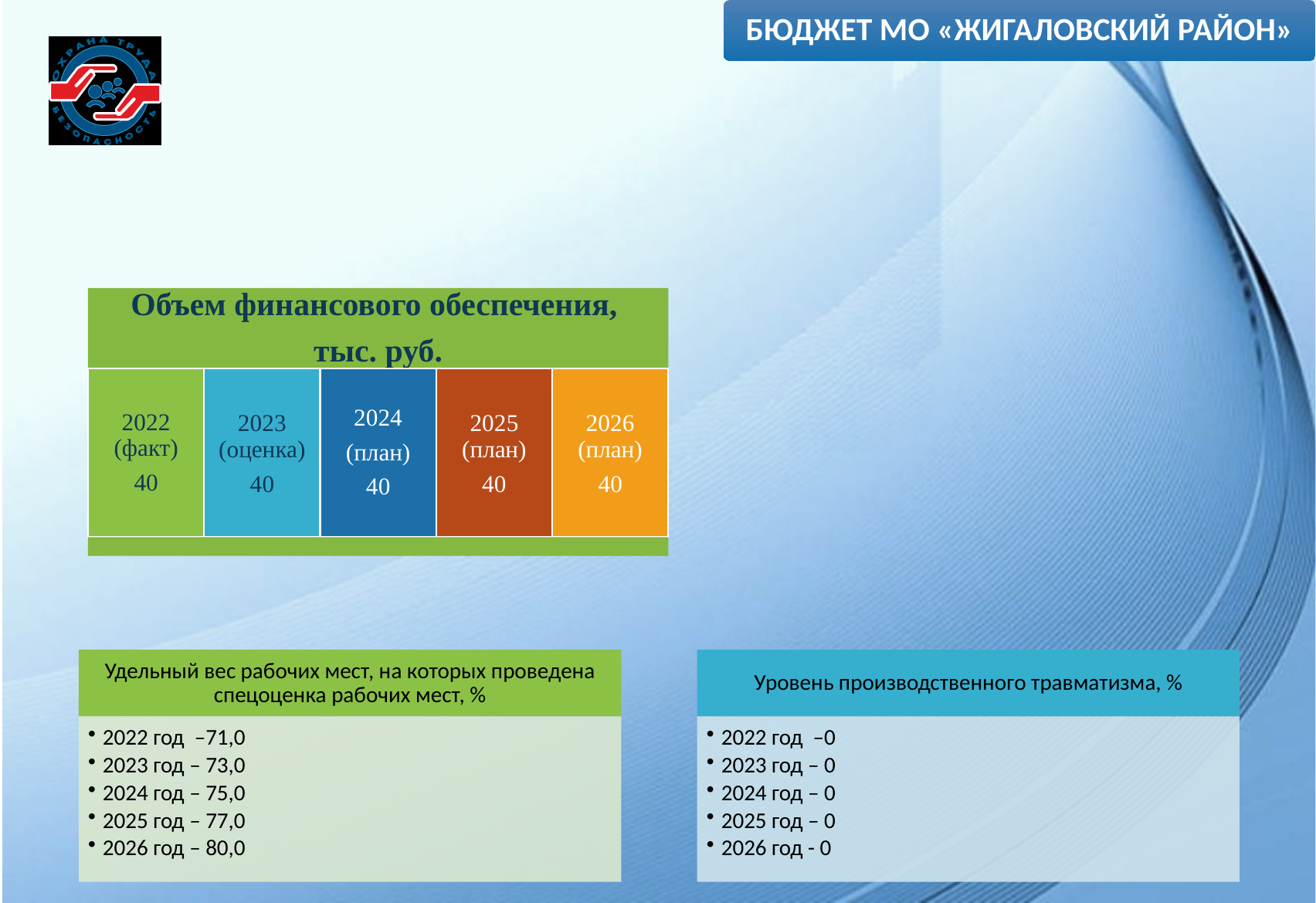
How many years are shown in the 'Объем финансового обеспечения, тыс. руб.' block? 5 In the 'Объем финансового обеспечения, тыс. руб.' block, which year is labelled 'факт'? 2022 What unit is given in the title of the 'Объем финансового обеспечения' block? тыс. руб. In the 'Объем финансового обеспечения, тыс. руб.' block, what is the value for 2025 (план)? 40 In the 'Объем финансового обеспечения, тыс. руб.' block, what is the value for 2023 (оценка)? 40 In the 'Объем финансового обеспечения, тыс. руб.' block, do the values rise, fall or stay the same from 2022 to 2026? stay the same In the 'Объем финансового обеспечения, тыс. руб.' block, what is the value for 2022 (факт)? 40 In the 'Объем финансового обеспечения, тыс. руб.' block, what is the difference between the values for 2026 (план) and 2022 (факт)? 0 In the 'Объем финансового обеспечения, тыс. руб.' block, what is the value for 2024 (план)? 40 In the 'Объем финансового обеспечения, тыс. руб.' block, what is the value for 2026 (план)? 40